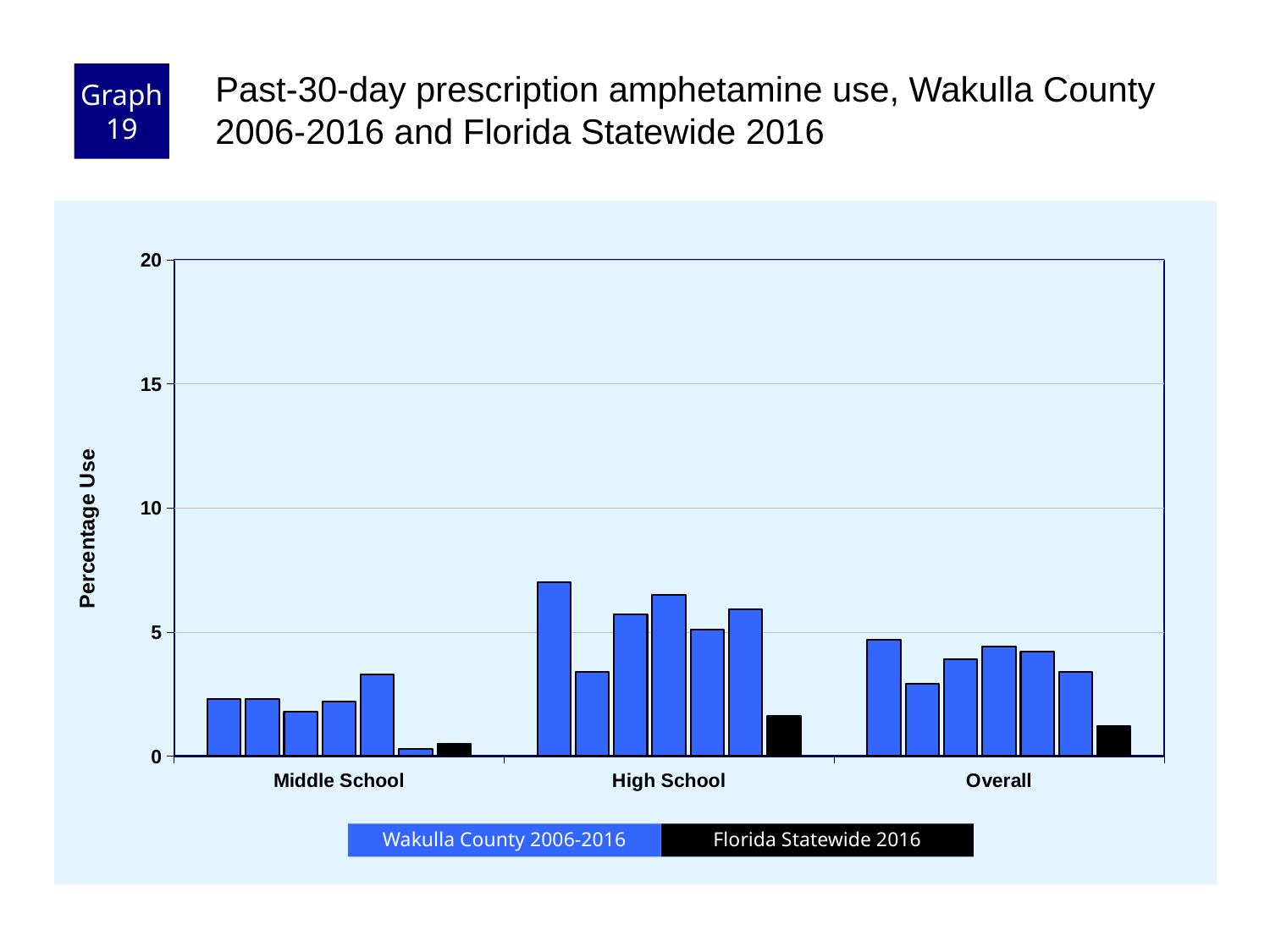
Which category has the lowest Florida Statewide 2016 bar? Middle School Which colour represents Florida Statewide 2016 in the legend? black Is the tallest Wakulla County 2006-2016 bar for High School greater or less than 5? greater Is the Florida Statewide 2016 value for High School greater or less than 5? less How many categories are shown on the x axis? 3 Is the Florida Statewide 2016 bar larger for High School or for Middle School? High School Are all the Middle School bars greater or less than 5? less Which category contains the tallest bar in the chart? High School What kind of chart is shown on the slide? bar chart What is the label on the y axis? Percentage Use How many series does the legend list? 2